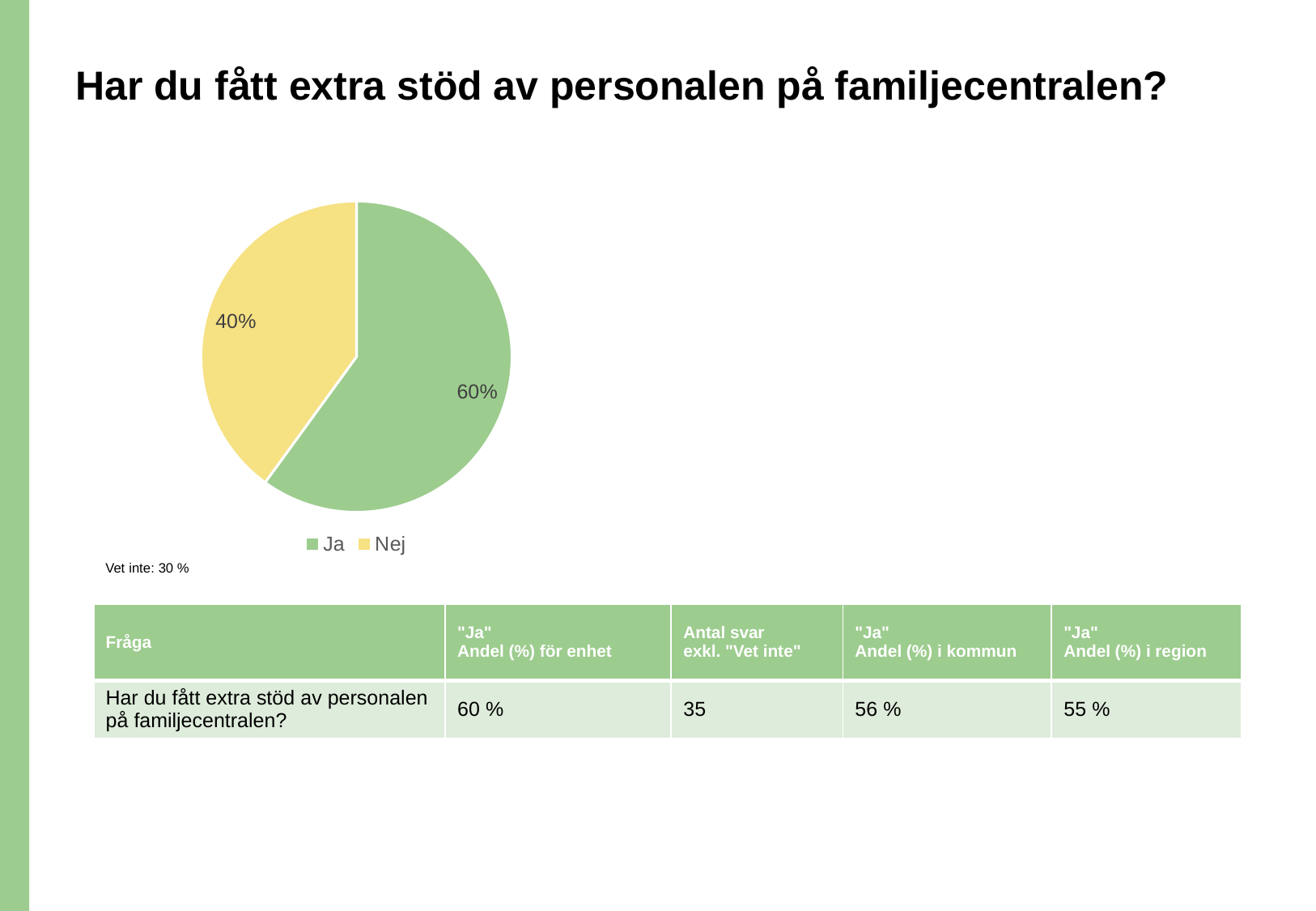
What share of the pie does the "Nej" slice represent? 40% Which slice of the pie is the smallest? Nej Which slice of the pie is the largest? Ja What is the difference in percentage points between the "Ja" and "Nej" slices? 20 What colour is the "Ja" slice in the pie chart? green How many entries does the legend list? 2 What kind of chart is shown on the slide? pie chart What colour is the "Nej" slice in the pie chart? yellow Which is larger, the "Ja" slice or the "Nej" slice? Ja Is the value for "Nej" greater or less than 50%? less What share of the pie does the "Ja" slice represent? 60% How many slices does the pie chart have? 2